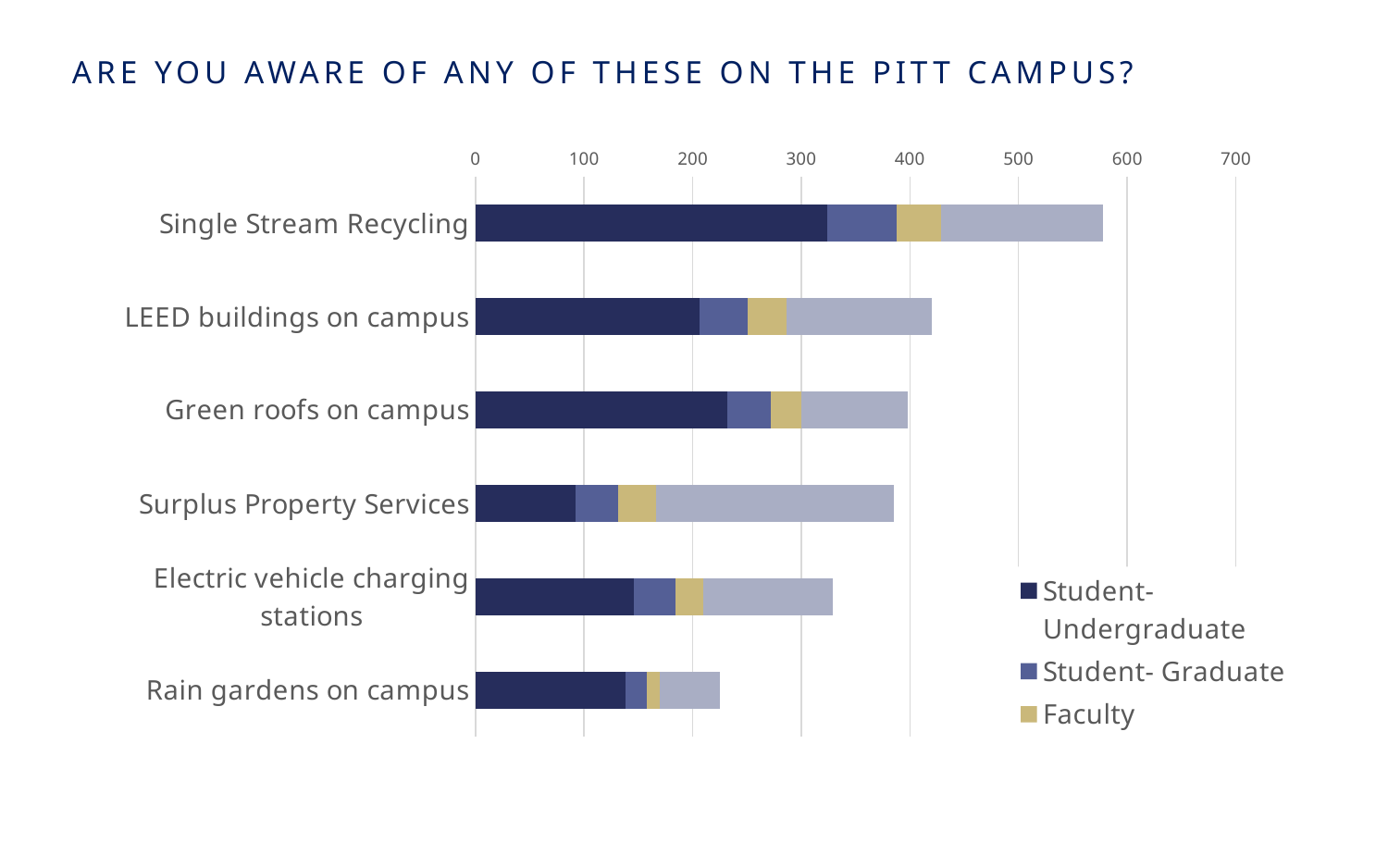
What is the title of the chart? ARE YOU AWARE OF ANY OF THESE ON THE PITT CAMPUS? Is the total bar for Rain gardens on campus greater or less than 300? less Is the total bar for Electric vehicle charging stations greater or less than 300? greater Which category has the longest total bar? Single Stream Recycling Is the total bar for Surplus Property Services greater or less than 400? less How many categories are plotted on the chart? 6 Which has a longer total bar, LEED buildings on campus or Rain gardens on campus? LEED buildings on campus What kind of chart is shown on the slide? Stacked bar chart How many series does the legend list? 3 Which category has the shortest total bar? Rain gardens on campus